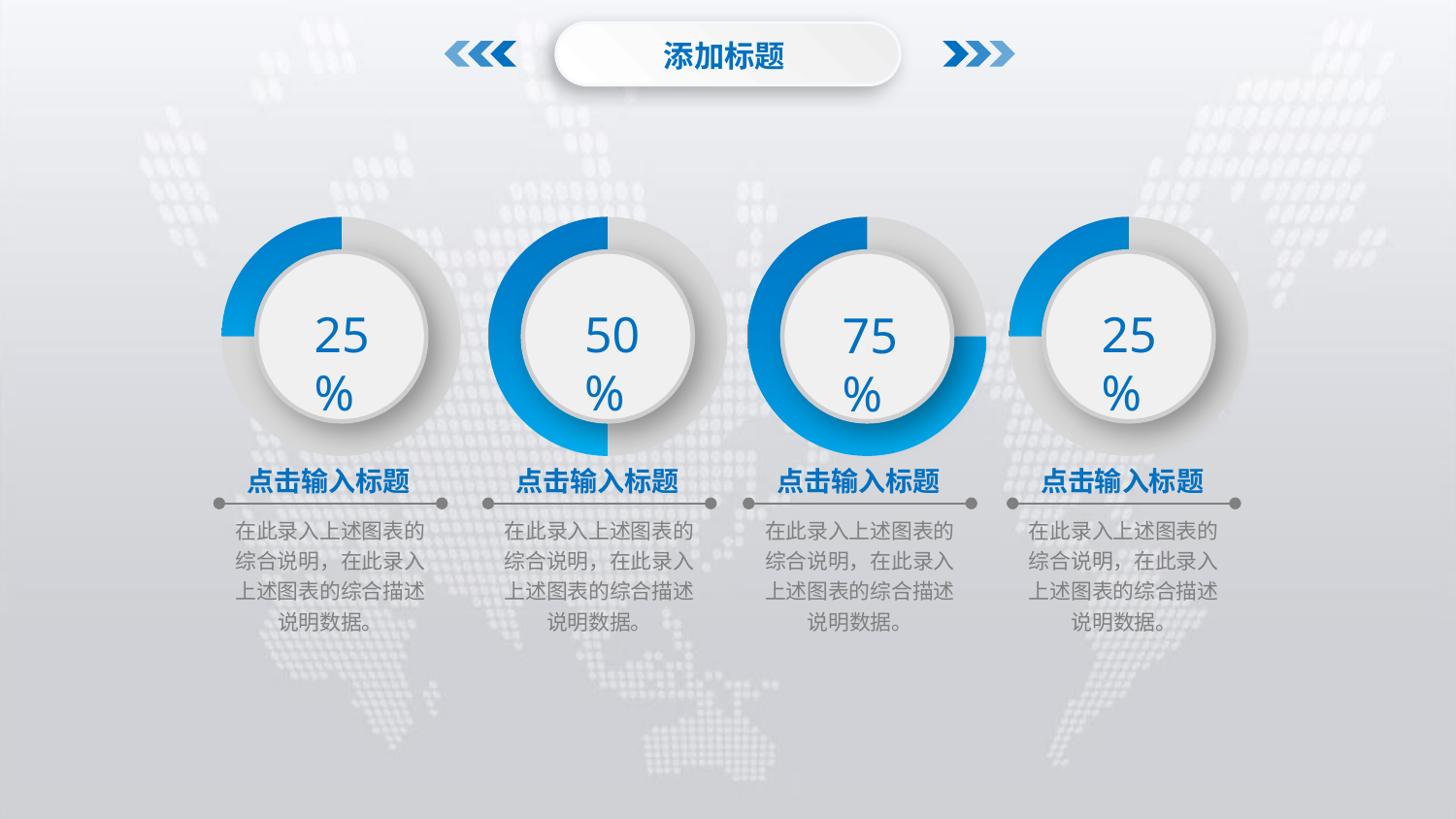
What value is shown in the second ring chart from the left? 50% What value is shown in the rightmost ring chart? 25% What value is shown in the leftmost ring chart? 25% What is the difference between the value in the third ring chart and the value in the leftmost ring chart? 50% How many ring charts are shown on the slide? 4 Which is larger, the value in the second ring chart or the value in the third ring chart? The third ring chart (75%) What kind of chart is used to display the percentages on the slide? Donut (ring) chart What value is shown in the third ring chart from the left? 75% What is the title text shown at the top of the slide? 添加标题 Which of the four ring charts shows the highest percentage? The third from the left (75%) What is the difference between the value in the second ring chart and the value in the rightmost ring chart? 25% What colour is used for the filled portion of each ring chart? Blue